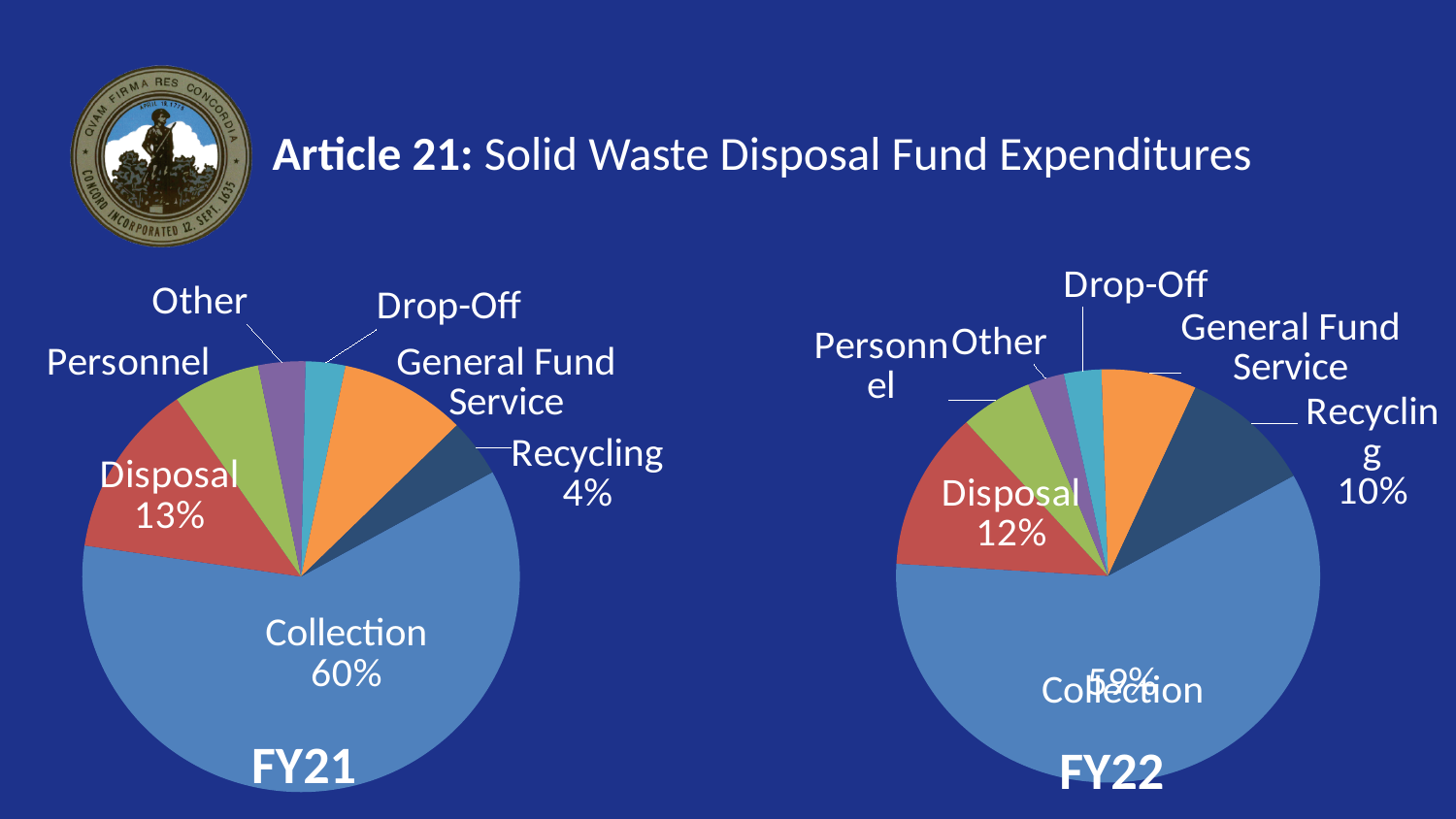
Is the Recycling share larger in the FY21 pie chart or the FY22 pie chart? FY22 In the FY21 pie chart, what share of expenditures is Recycling? 4% In the FY22 pie chart, what share of expenditures is Collection? 59% In the FY21 pie chart, what share of expenditures is Disposal? 13% In the FY22 pie chart, what share of expenditures is Recycling? 10% In the FY22 pie chart, what share of expenditures is Disposal? 12% How many categories are shown in the FY21 pie chart? 7 In the FY22 pie chart, which category has the largest share? Collection In the FY21 pie chart, what share of expenditures is Collection? 60% What is the difference between the Collection share in the FY21 pie chart and in the FY22 pie chart? 1% In the FY21 pie chart, which category has the largest share? Collection What kind of chart is used for FY21 and FY22 on this slide? Pie chart